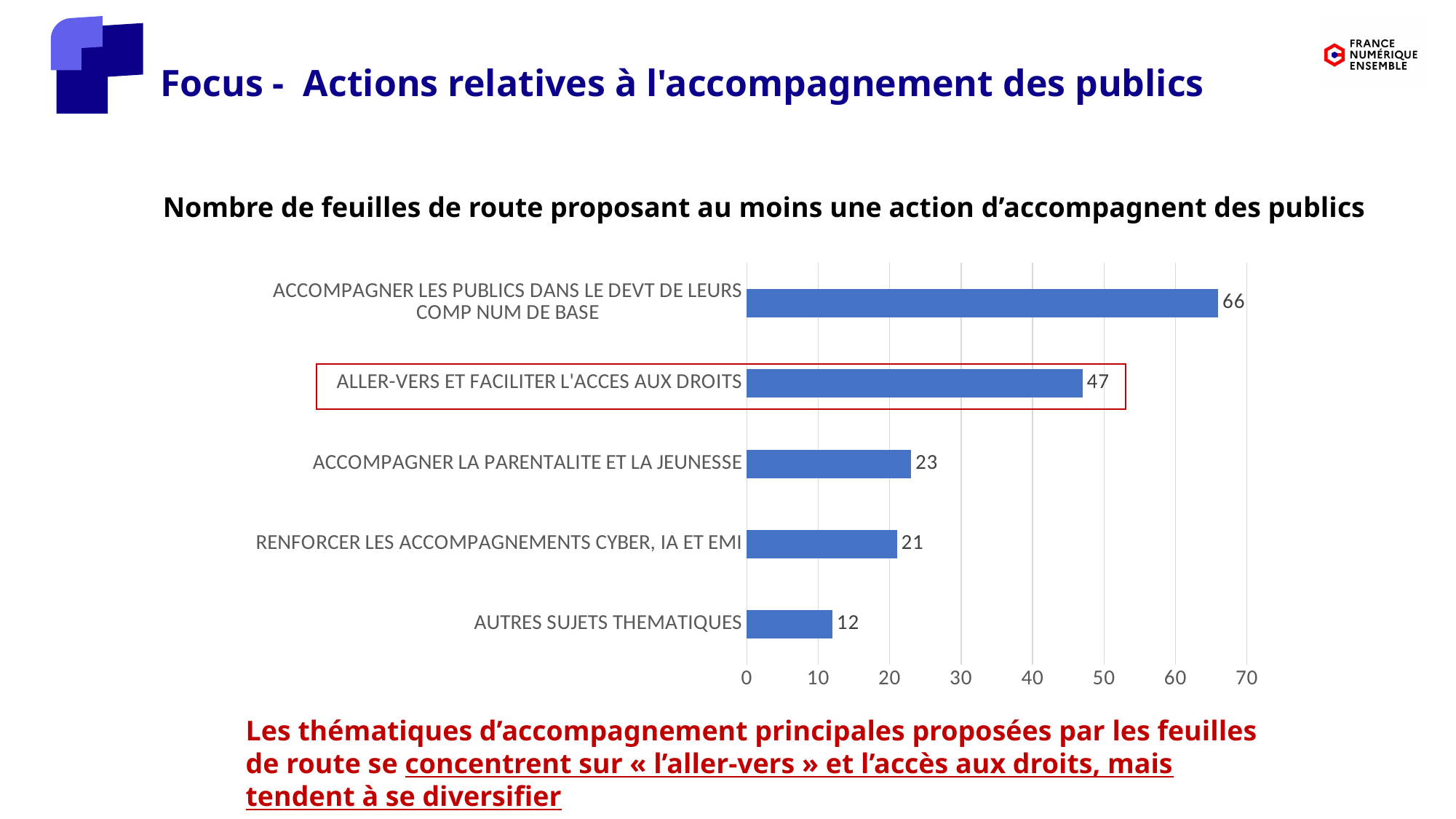
What kind of chart is shown on the slide? bar chart What is the difference between the values for ACCOMPAGNER LES PUBLICS DANS LE DEVT DE LEURS COMP NUM DE BASE and ALLER-VERS ET FACILITER L'ACCES AUX DROITS? 19 What is the value for AUTRES SUJETS THEMATIQUES? 12 What is the value for RENFORCER LES ACCOMPAGNEMENTS CYBER, IA ET EMI? 21 Which is larger: the value for ACCOMPAGNER LA PARENTALITE ET LA JEUNESSE or the value for RENFORCER LES ACCOMPAGNEMENTS CYBER, IA ET EMI? ACCOMPAGNER LA PARENTALITE ET LA JEUNESSE How many categories are shown in the chart? 5 What is the value for ACCOMPAGNER LA PARENTALITE ET LA JEUNESSE? 23 What is the title of the chart? Nombre de feuilles de route proposant au moins une action d’accompagnent des publics Which category has the lowest value? AUTRES SUJETS THEMATIQUES Is the value for ALLER-VERS ET FACILITER L'ACCES AUX DROITS greater or less than 40? greater Which category has the highest value? ACCOMPAGNER LES PUBLICS DANS LE DEVT DE LEURS COMP NUM DE BASE What is the value for ALLER-VERS ET FACILITER L'ACCES AUX DROITS? 47